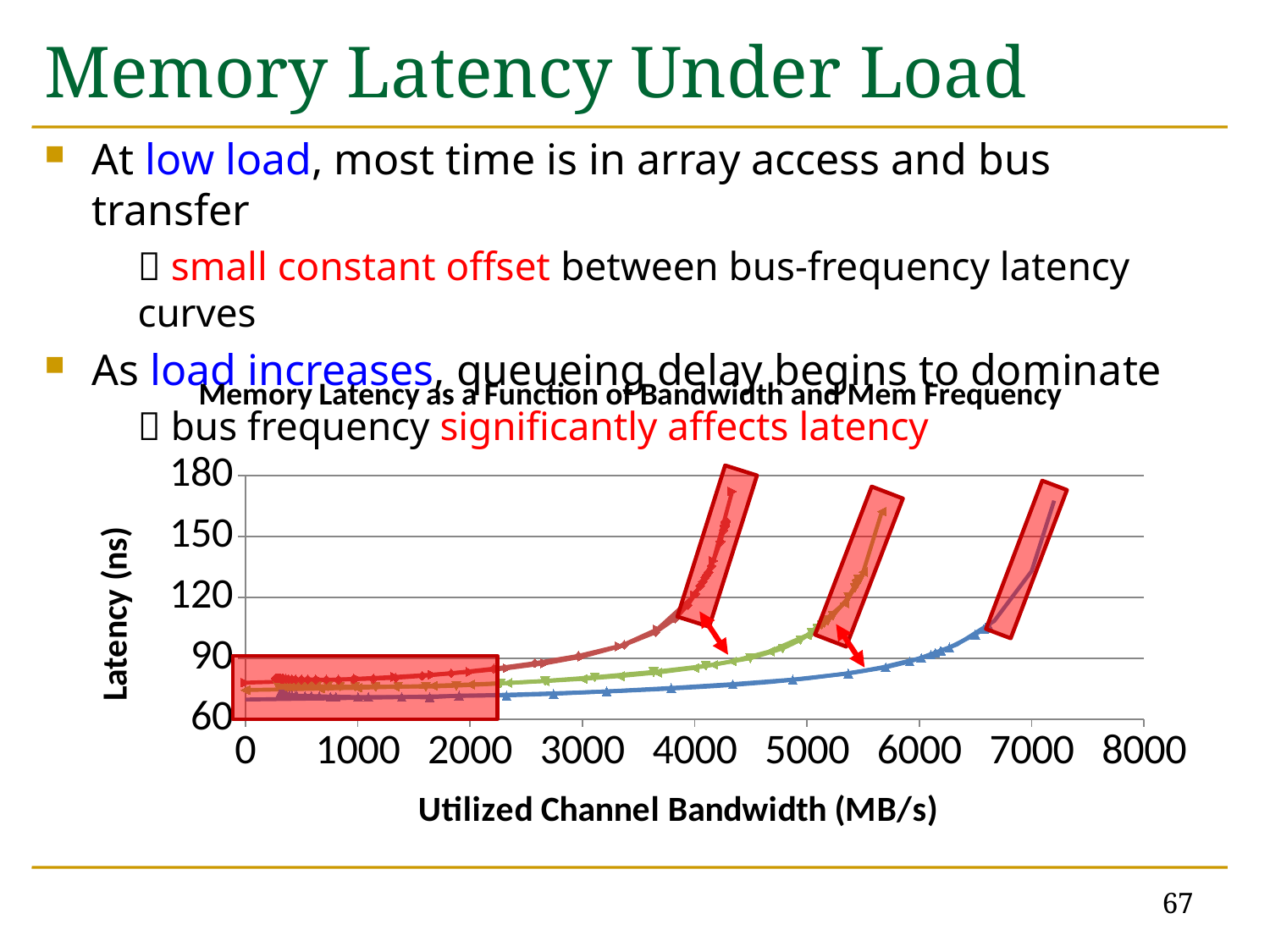
Is the latency of the red curve at 4000 MB/s greater or less than 90 ns? greater Is the latency of the blue curve at 1000 MB/s greater or less than 90 ns? less What is the highest value shown on the y axis of the chart? 180 Which curve reaches the highest utilized channel bandwidth before its latency shoots up? blue curve What is the title of the chart? Memory Latency as a Function of Bandwidth and Mem Frequency What is the label of the x axis of the chart? Utilized Channel Bandwidth (MB/s) At 2000 MB/s, which curve has the higher latency, the red curve or the blue curve? red curve What kind of chart is shown on the slide? line chart Which curve's latency shoots up at the lowest utilized channel bandwidth? red curve As utilized channel bandwidth increases along the x axis, does latency rise or fall? rise